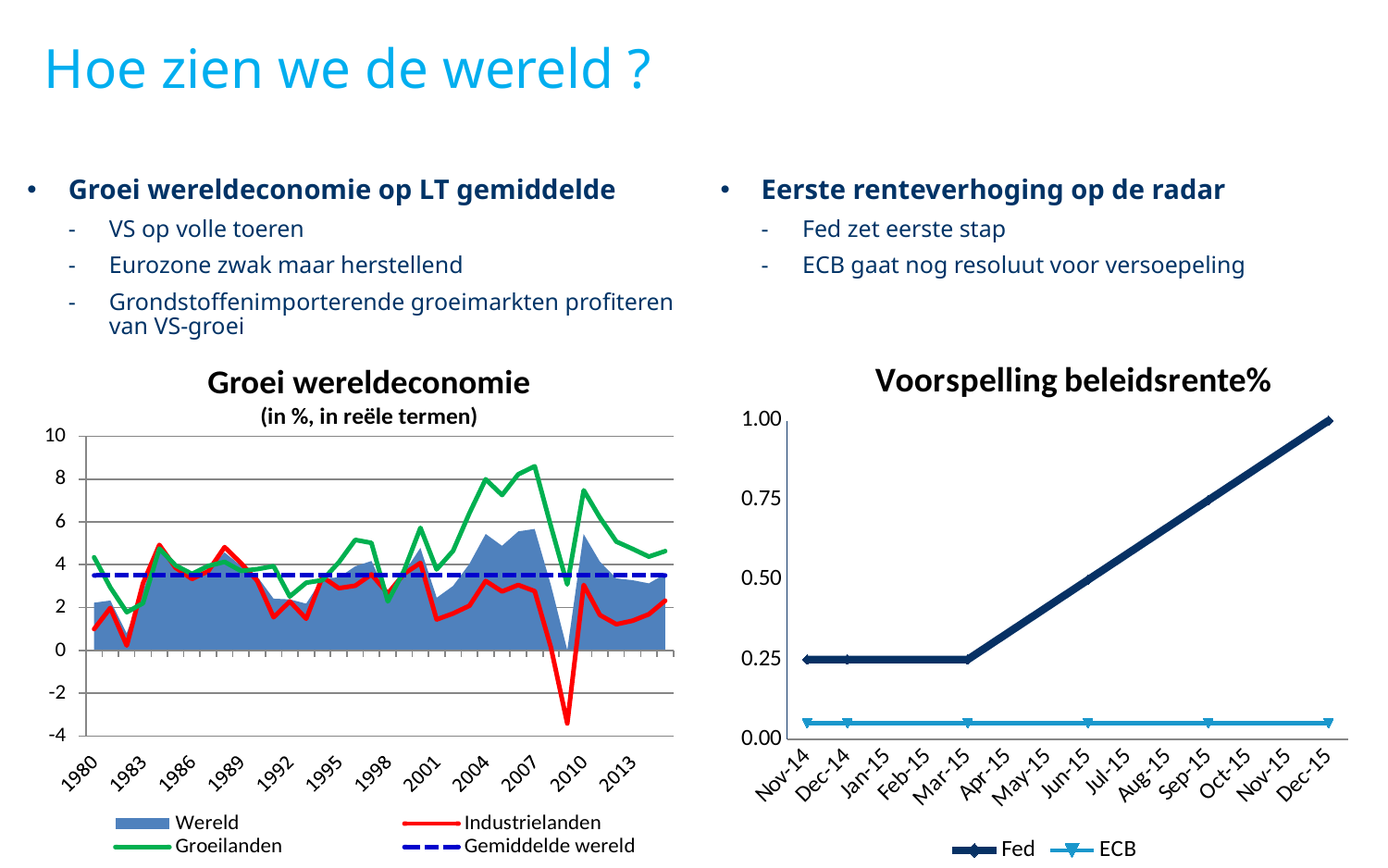
In the 'Voorspelling beleidsrente%' chart, is the value for ECB in Jun-15 greater or less than 0.25? less What is the subtitle shown under the title of the 'Groei wereldeconomie' chart? (in %, in reële termen) In the 'Voorspelling beleidsrente%' chart, does the Fed line rise or fall between Mar-15 and Dec-15? rise In the 'Voorspelling beleidsrente%' chart, what is the value for Fed in Nov-14? 0.25 How many months are shown on the x axis of the 'Voorspelling beleidsrente%' chart? 14 In the 'Groei wereldeconomie' chart, which series is drawn as a dashed blue line? Gemiddelde wereld What kind of chart is the 'Voorspelling beleidsrente%' chart? line chart How many series does the legend of the 'Groei wereldeconomie' chart list? 4 In the 'Voorspelling beleidsrente%' chart, which series is higher in Dec-15, Fed or ECB? Fed How many series does the legend of the 'Voorspelling beleidsrente%' chart list? 2 In the 'Groei wereldeconomie' chart, is the value for Groeilanden in 2010 greater or less than 6? greater In the 'Voorspelling beleidsrente%' chart, what is the value for Fed in Dec-15? 1.00